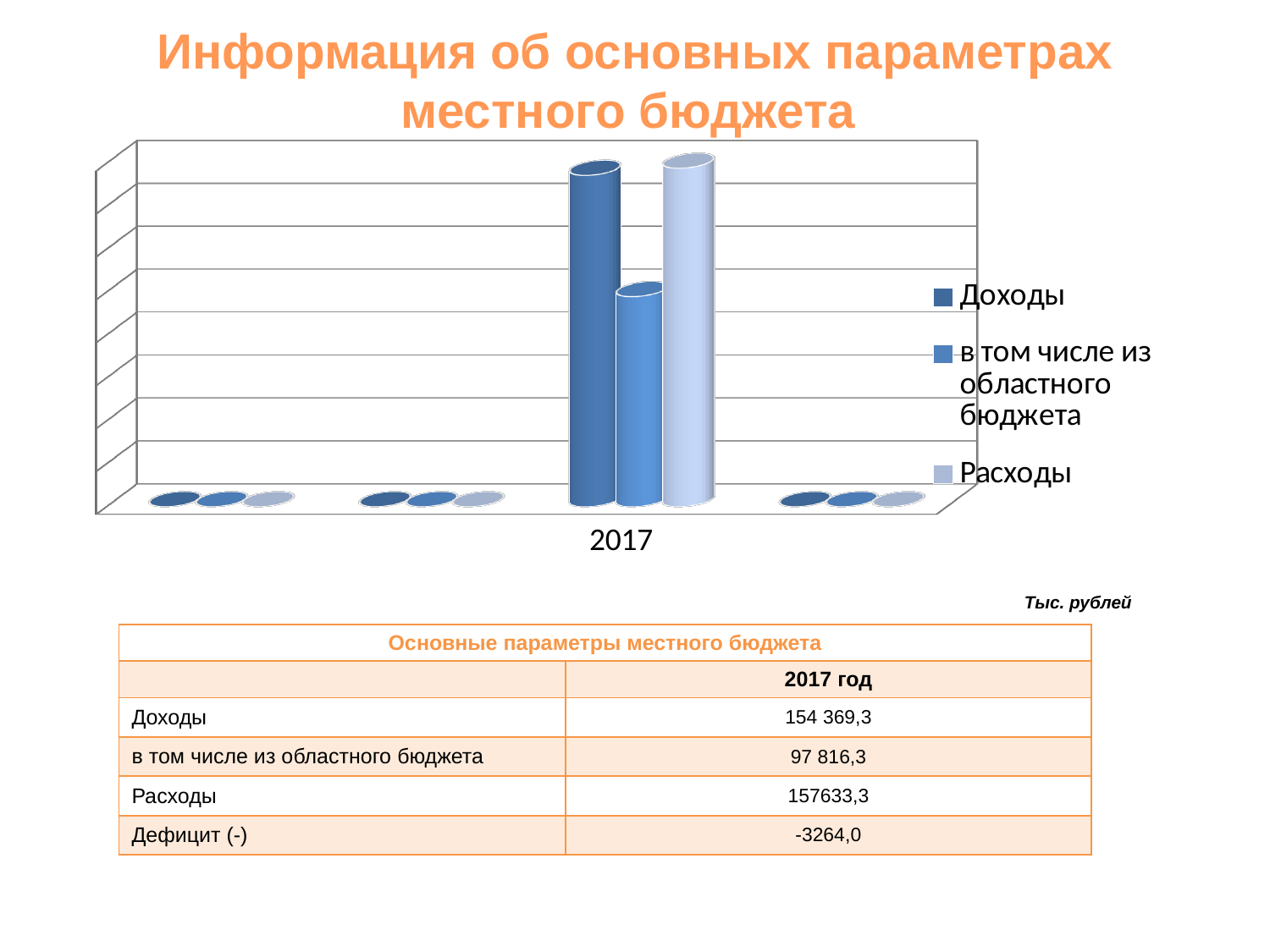
What kind of chart is shown on the slide? bar chart According to the table on the slide, what is the value of Доходы for 2017? 154 369,3 Which year is labelled on the x axis of the chart? 2017 According to the table on the slide, what is the value of Расходы for 2017? 157633,3 According to the table on the slide, what is the value of 'в том числе из областного бюджета' for 2017? 97 816,3 In what units are the budget values on the slide given? Тыс. рублей How many series does the chart legend list? 3 In the chart, which bar is taller for 2017: Расходы or в том числе из областного бюджета? Расходы What are the three series listed in the chart legend? Доходы, в том числе из областного бюджета, Расходы In the chart, which bar is taller for 2017: Доходы or в том числе из областного бюджета? Доходы According to the table on the slide, what is the value of Дефицит (-) for 2017? -3264,0 Which series has the lowest bar in the chart for 2017? в том числе из областного бюджета